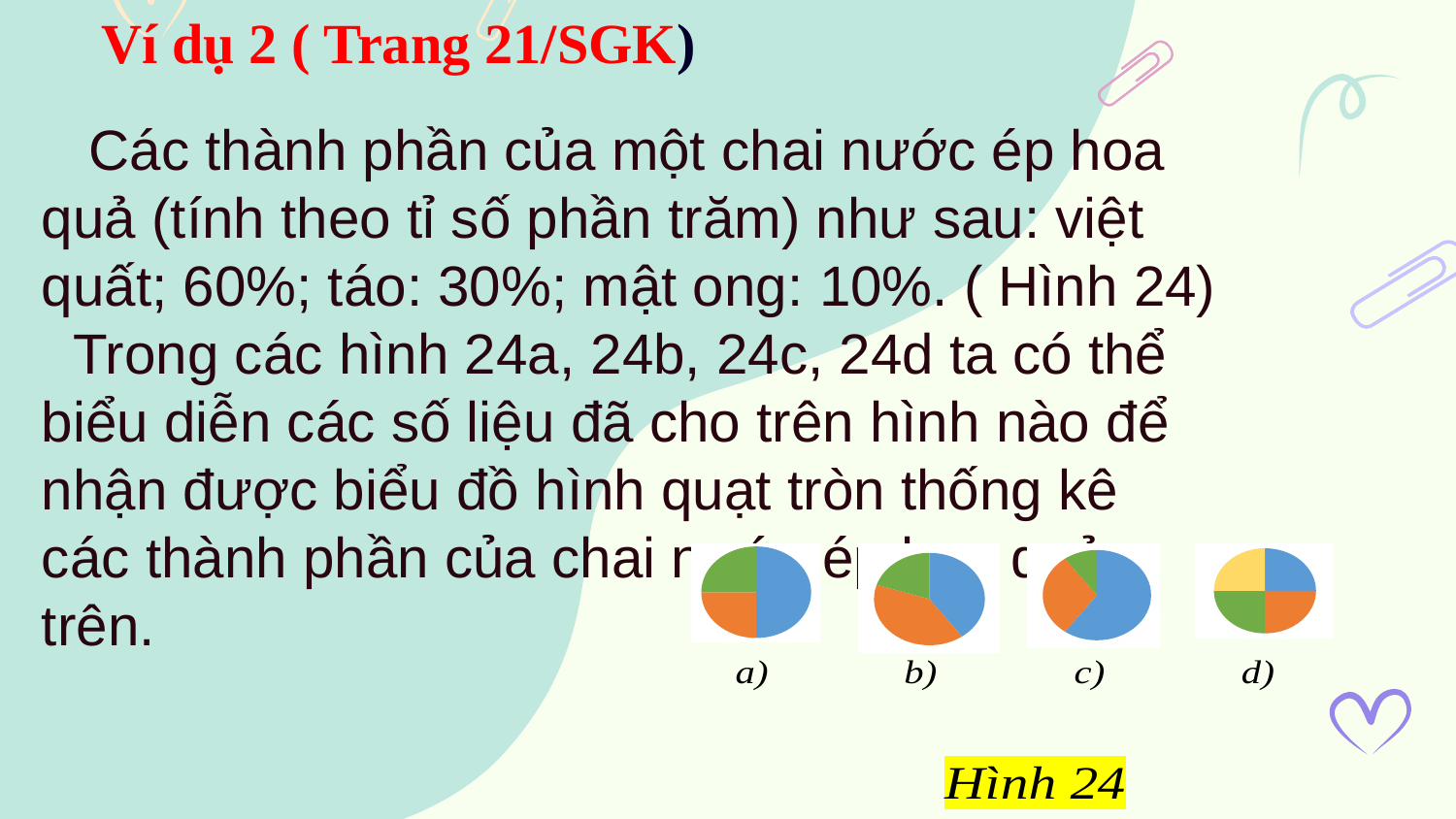
In pie chart a), is the blue slice larger or smaller than the green slice? larger Which pie chart on the slide contains a yellow slice? d) How many slices does pie chart a) have? 3 In pie chart a), which colour slice is the largest? blue How many pie charts are shown in Hình 24 on the slide? 4 How many slices does pie chart d) have? 4 In pie chart c), which colour slice is the largest? blue In pie chart c), which colour slice is the smallest? green In pie chart b), which colour slice is the smallest? green What is the figure caption shown below the four pie charts? Hình 24 What kind of chart is chart a) on the slide? pie chart